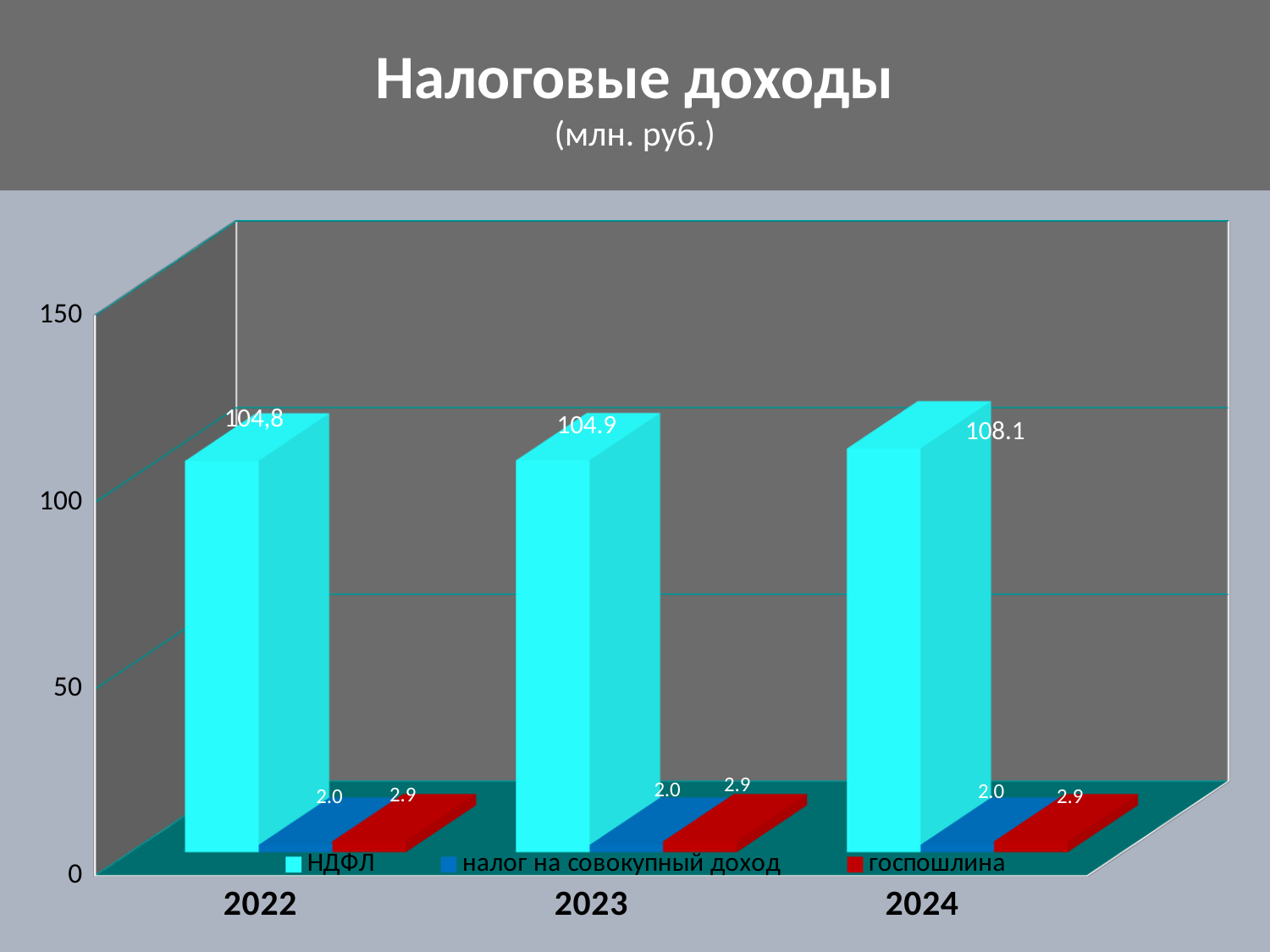
What is the value for НДФЛ in 2022? 104,8 What is the value for налог на совокупный доход in 2024? 2.0 What kind of chart is shown on the slide? bar chart Does the value for НДФЛ rise or fall from 2022 to 2024? rises How many years are shown on the x axis? 3 What is the value for НДФЛ in 2024? 108.1 In 2022, which is larger: госпошлина or налог на совокупный доход? госпошлина What is the difference between the НДФЛ values for 2024 and 2023? 3.2 How many series does the legend list? 3 Is the value for НДФЛ in 2023 greater or less than 100? greater In which year is the value for НДФЛ the highest? 2024 What is the value for госпошлина in 2023? 2.9